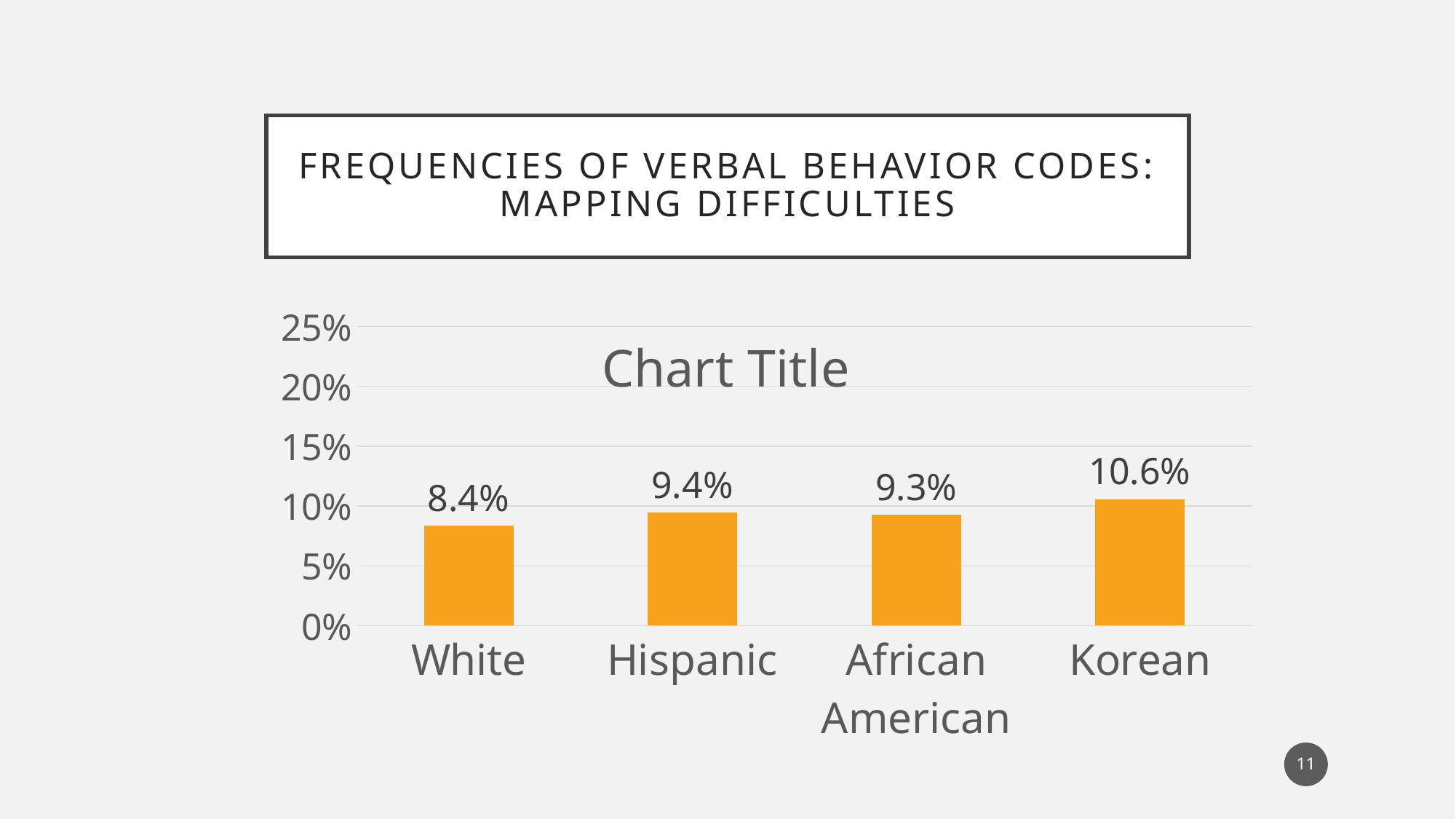
What is the value for Hispanic? 9.4% What is the difference between the values for Korean and White? 2.2% What is the value for White? 8.4% Which category has the highest value? Korean Which is larger, the value for Korean or the value for Hispanic? Korean Is the value for Korean greater or less than 10%? greater What is the difference between the values for Hispanic and African American? 0.1% What kind of chart is shown on the slide? bar chart What is the value for African American? 9.3% What is the value for Korean? 10.6% How many categories are shown on the x axis? 4 Which category has the lowest value? White